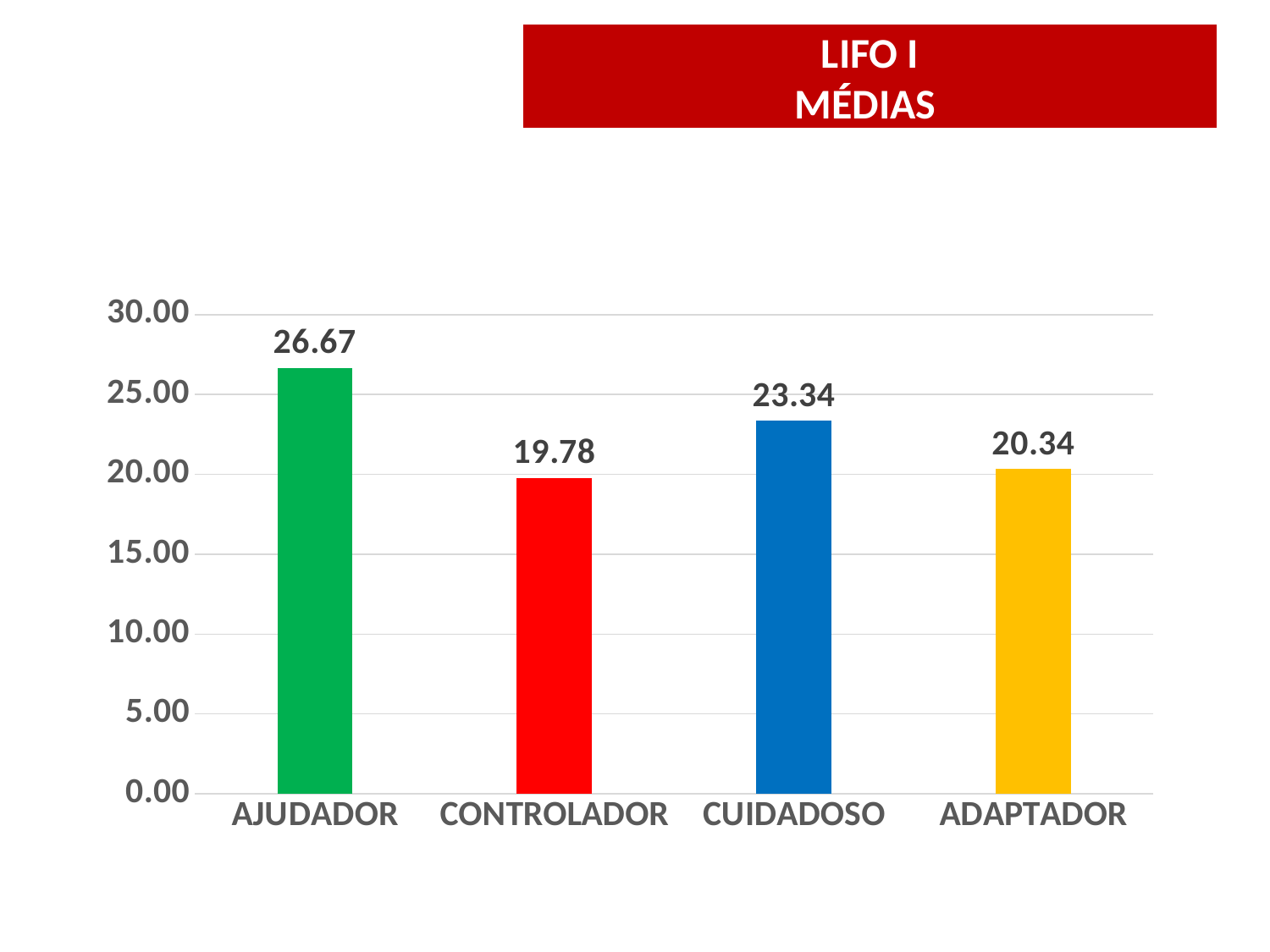
How many categories are shown on the chart? 4 What is the difference between the values for CUIDADOSO and ADAPTADOR? 3.00 Which category has the lowest value? CONTROLADOR What is the value for CUIDADOSO? 23.34 What is the value for CONTROLADOR? 19.78 Which is larger, the value for CUIDADOSO or the value for ADAPTADOR? CUIDADOSO Which category has the highest value? AJUDADOR What is the difference between the values for AJUDADOR and CONTROLADOR? 6.89 What is the value for AJUDADOR? 26.67 Is the value for CONTROLADOR greater or less than 20.00? less What kind of chart is shown on the slide? bar chart What is the value for ADAPTADOR? 20.34